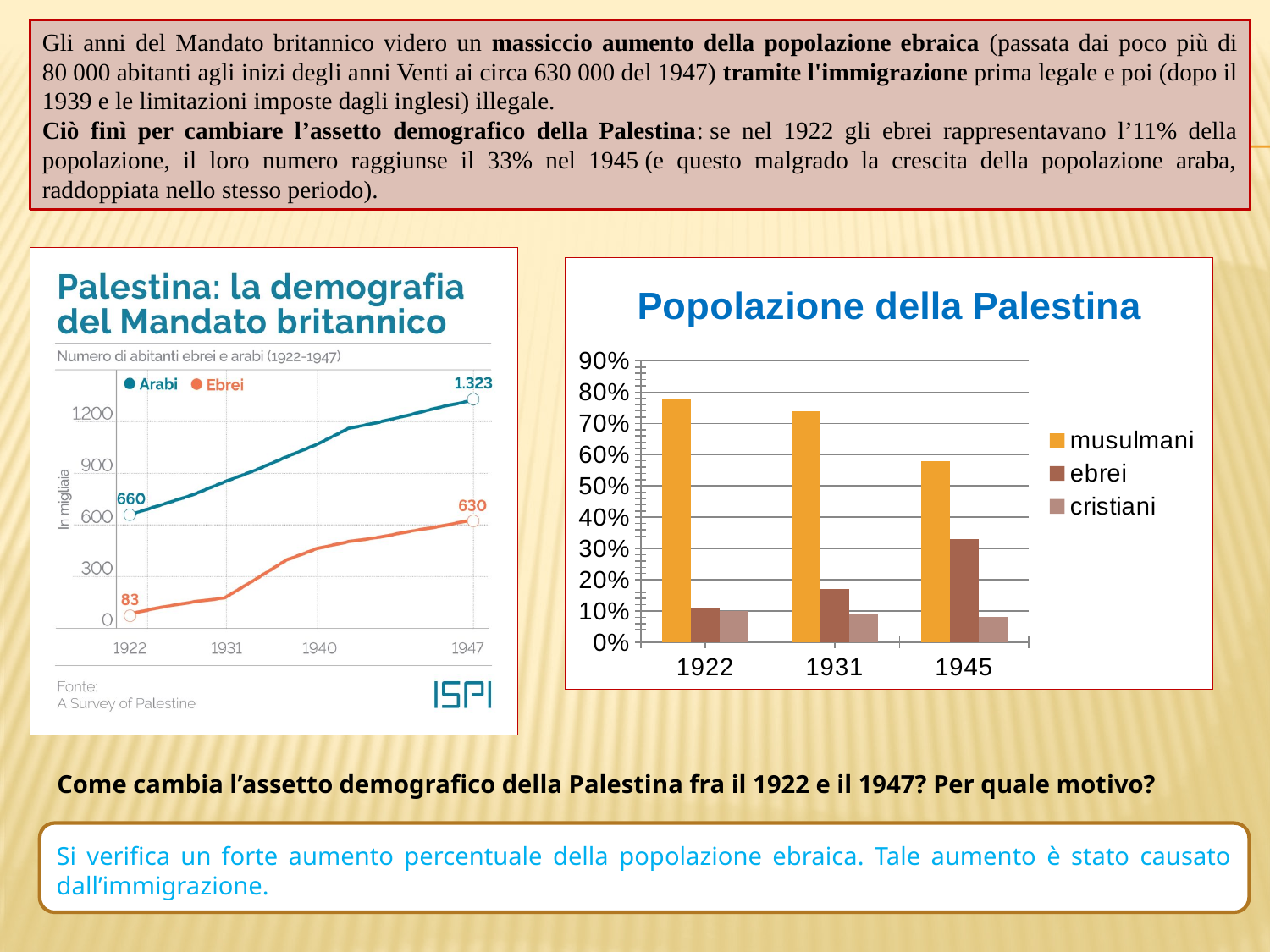
On the chart titled 'Palestina: la demografia del Mandato britannico', by how much did the Ebrei value increase from 1922 to 1947? 547 On the chart titled 'Popolazione della Palestina', in which year is the musulmani bar highest? 1922 On the chart titled 'Palestina: la demografia del Mandato britannico', which series has the higher value in 1947, Arabi or Ebrei? Arabi On the chart titled 'Popolazione della Palestina', how many series does the legend list? 3 On the chart titled 'Palestina: la demografia del Mandato britannico', what is the value for Arabi in 1922? 660 On the chart titled 'Popolazione della Palestina', do the ebrei values rise or fall from 1922 to 1945? rise On the chart titled 'Palestina: la demografia del Mandato britannico', what is the value for Arabi in 1947? 1.323 What kind of chart is the one titled 'Palestina: la demografia del Mandato britannico'? line chart On the chart titled 'Popolazione della Palestina', is the value for musulmani in 1922 greater or less than 70%? greater On the chart titled 'Palestina: la demografia del Mandato britannico', what is the value for Ebrei in 1947? 630 On the chart titled 'Palestina: la demografia del Mandato britannico', what is the value for Ebrei in 1922? 83 On the chart titled 'Popolazione della Palestina', how many years are shown on the x axis? 3